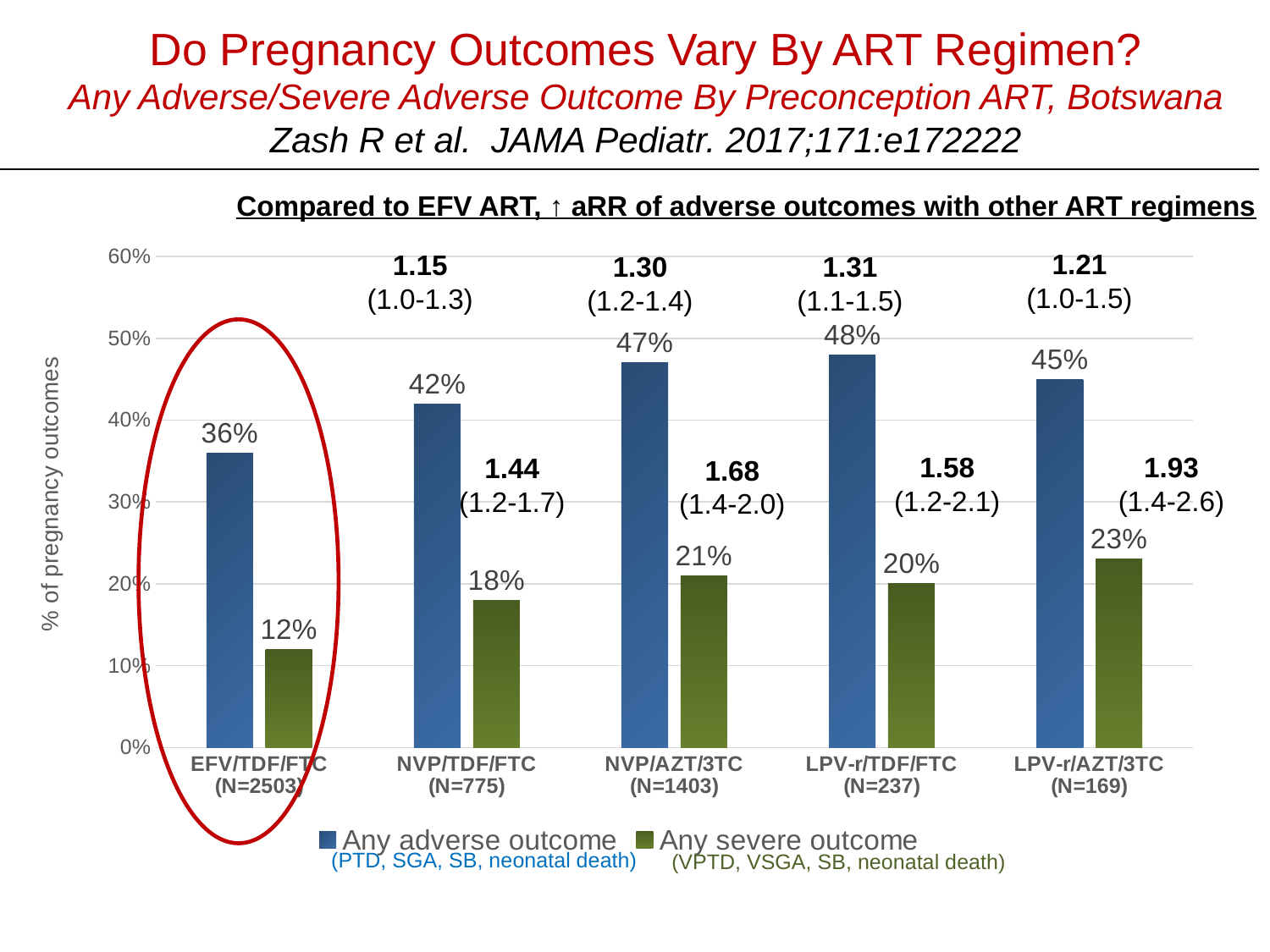
What is the difference between Any adverse outcome and Any severe outcome for NVP/AZT/3TC? 26% Which regimen has the highest value for Any adverse outcome? LPV-r/TDF/FTC What is the value for Any adverse outcome for EFV/TDF/FTC? 36% Which is larger: Any adverse outcome for NVP/TDF/FTC or Any adverse outcome for LPV-r/AZT/3TC? LPV-r/AZT/3TC How many series does the legend list? 2 What kind of chart is shown on the slide? bar chart Is the value for Any severe outcome for LPV-r/TDF/FTC greater or less than 30%? less Which regimen has the lowest value for Any severe outcome? EFV/TDF/FTC What is the value for Any severe outcome for NVP/TDF/FTC? 18% What is the label of the y axis? % of pregnancy outcomes How many ART regimens are shown on the x axis? 5 What is the value for Any severe outcome for LPV-r/AZT/3TC? 23%